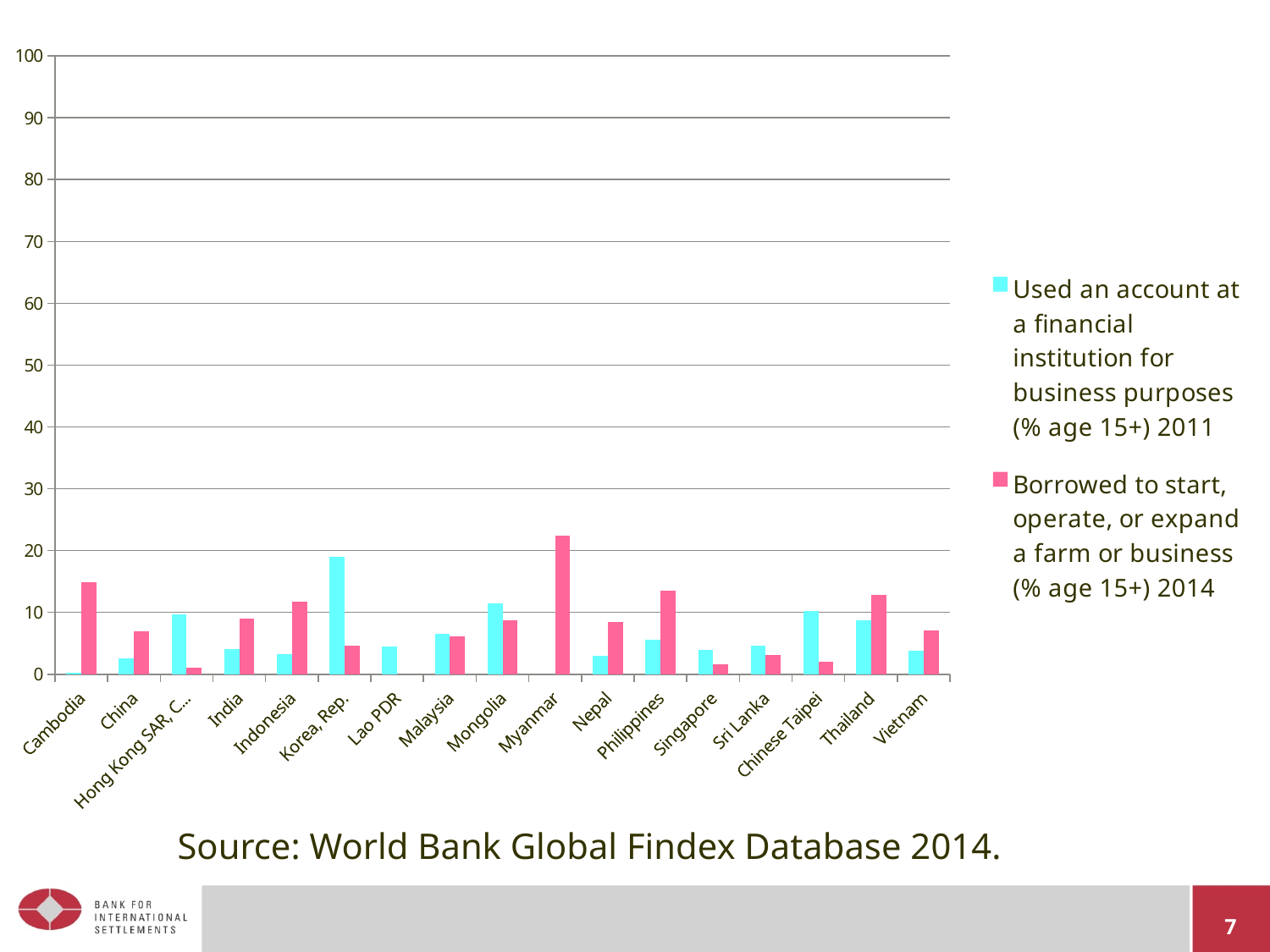
What colour represents the 'Borrowed to start, operate, or expand a farm or business (% age 15+) 2014' series? Pink Is the value for Hong Kong SAR in the 'Borrowed to start, operate, or expand a farm or business (% age 15+) 2014' series greater or less than 10? less For Chinese Taipei, which series has the larger value: 'Used an account at a financial institution for business purposes (% age 15+) 2011' or 'Borrowed to start, operate, or expand a farm or business (% age 15+) 2014'? Used an account at a financial institution for business purposes (% age 15+) 2011 Is the value for Korea, Rep. in the 'Used an account at a financial institution for business purposes (% age 15+) 2011' series greater or less than 10? greater Is the value for Myanmar in the 'Borrowed to start, operate, or expand a farm or business (% age 15+) 2014' series greater or less than 20? greater How many countries or economies are shown on the x axis? 17 For Cambodia, which series has the larger value: 'Used an account at a financial institution for business purposes (% age 15+) 2011' or 'Borrowed to start, operate, or expand a farm or business (% age 15+) 2014'? Borrowed to start, operate, or expand a farm or business (% age 15+) 2014 Which country has the highest value for 'Used an account at a financial institution for business purposes (% age 15+) 2011'? Korea, Rep. What kind of chart is shown on the slide? Bar chart Which country has the highest value for 'Borrowed to start, operate, or expand a farm or business (% age 15+) 2014'? Myanmar How many series does the legend list? 2